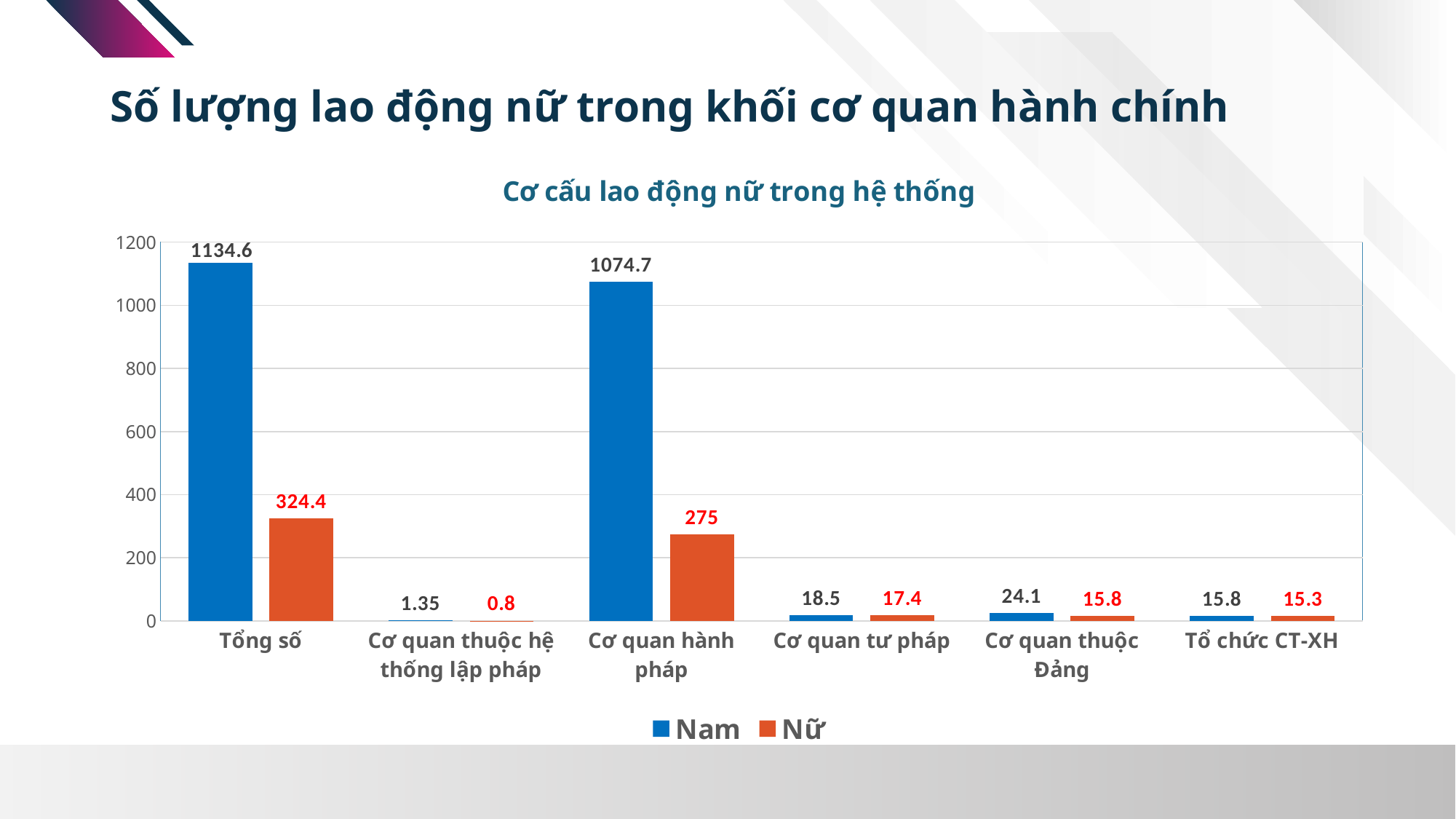
What is the difference between the Nam and Nữ values for Tổng số? 810.2 Excluding Tổng số, which category has the highest Nữ value? Cơ quan hành pháp What is the Nữ value for Cơ quan thuộc hệ thống lập pháp? 0.8 What is the Nam value for Tổng số? 1134.6 Which is larger for Cơ quan tư pháp, the Nam value or the Nữ value? Nam How many series does the legend list? 2 What is the Nam value for Cơ quan thuộc Đảng? 24.1 Which category has the lowest Nam value? Cơ quan thuộc hệ thống lập pháp Is the Nữ value for Tổng số greater or less than 400? less How many categories are shown on the x axis? 6 What is the Nữ value for Cơ quan hành pháp? 275 What kind of chart is shown? bar chart